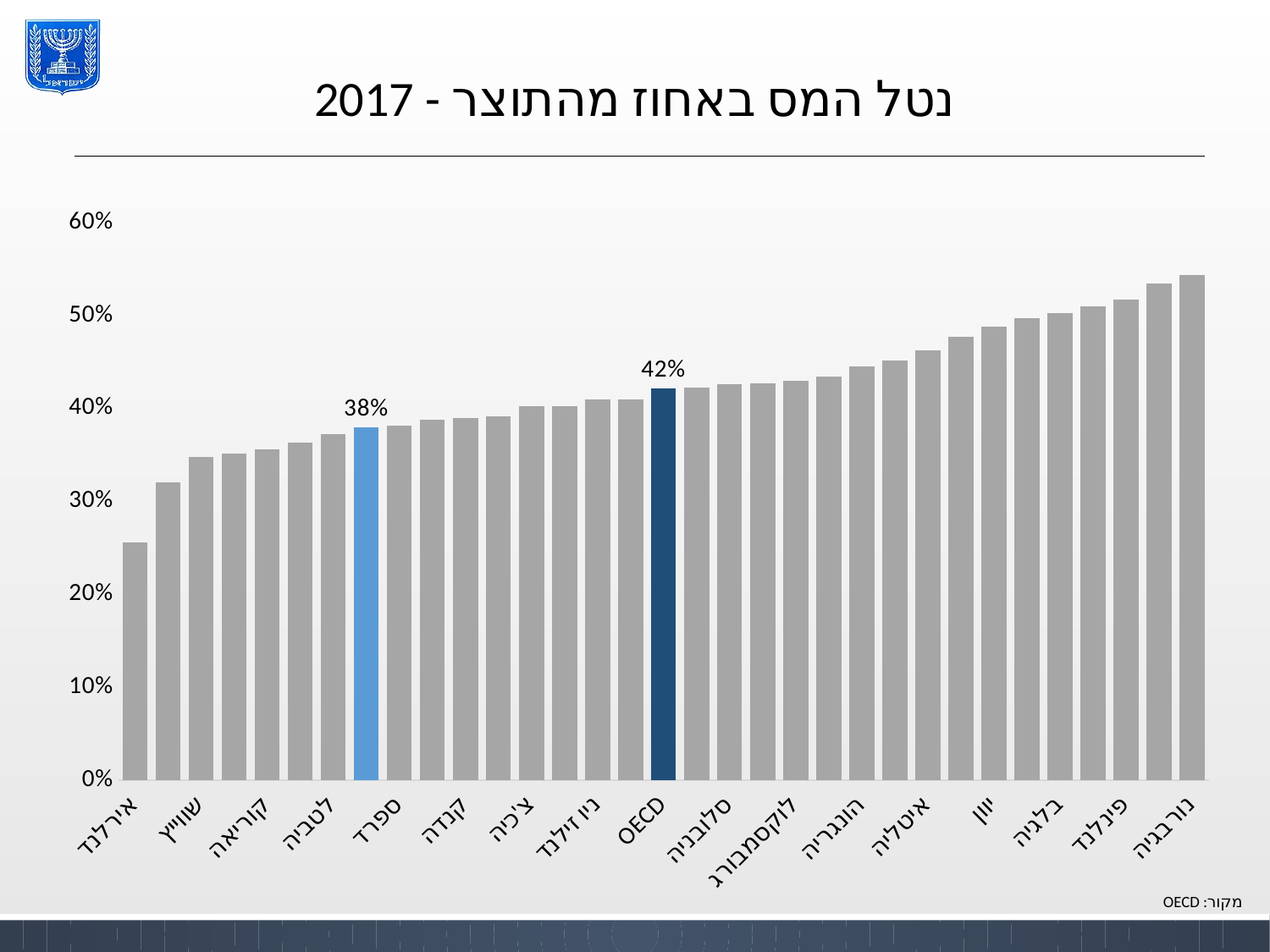
Is the value for יוון greater or less than 50%? less Is the value for אירלנד greater or less than 30%? less What kind of chart is shown on the slide? bar chart Which country has the highest bar in the chart? נורבגיה Is the value for נורבגיה greater or less than 50%? greater Which country has the lowest bar in the chart? אירלנד Do the bar values rise or fall from left to right across the chart? rise Which is larger, the value for OECD or the value for ספרד? OECD What is the value shown for OECD? 42%